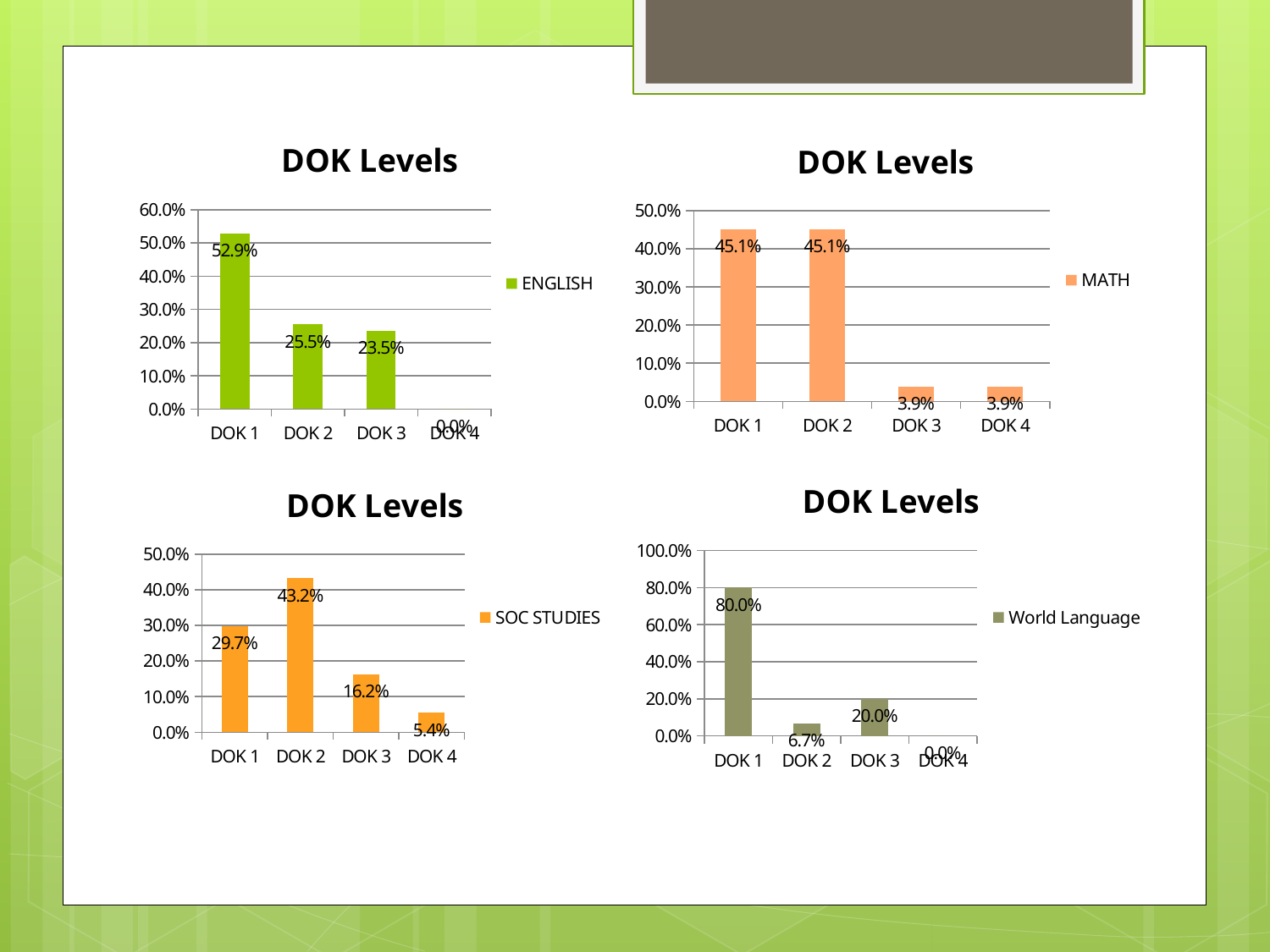
In the ENGLISH chart (top left), what is the value for DOK 1? 52.9% How many DOK level categories are shown in the MATH chart (top right)? 4 In the SOC STUDIES chart (bottom left), which is larger, the value for DOK 1 or DOK 3? DOK 1 In the MATH chart (top right), what is the value for DOK 3? 3.9% What is the title shared by all four charts on the slide? DOK Levels What type of chart is the World Language chart (bottom right)? Bar chart In the World Language chart (bottom right), which DOK level has the lowest value? DOK 4 In the SOC STUDIES chart (bottom left), which DOK level has the highest value? DOK 2 In the MATH chart (top right), what is the value for DOK 2? 45.1% How many series does the legend of the SOC STUDIES chart (bottom left) list? 1 In the World Language chart (bottom right), is the value for DOK 1 greater or less than 60.0%? greater In the ENGLISH chart (top left), what is the difference between the DOK 1 and DOK 2 values? 27.4%